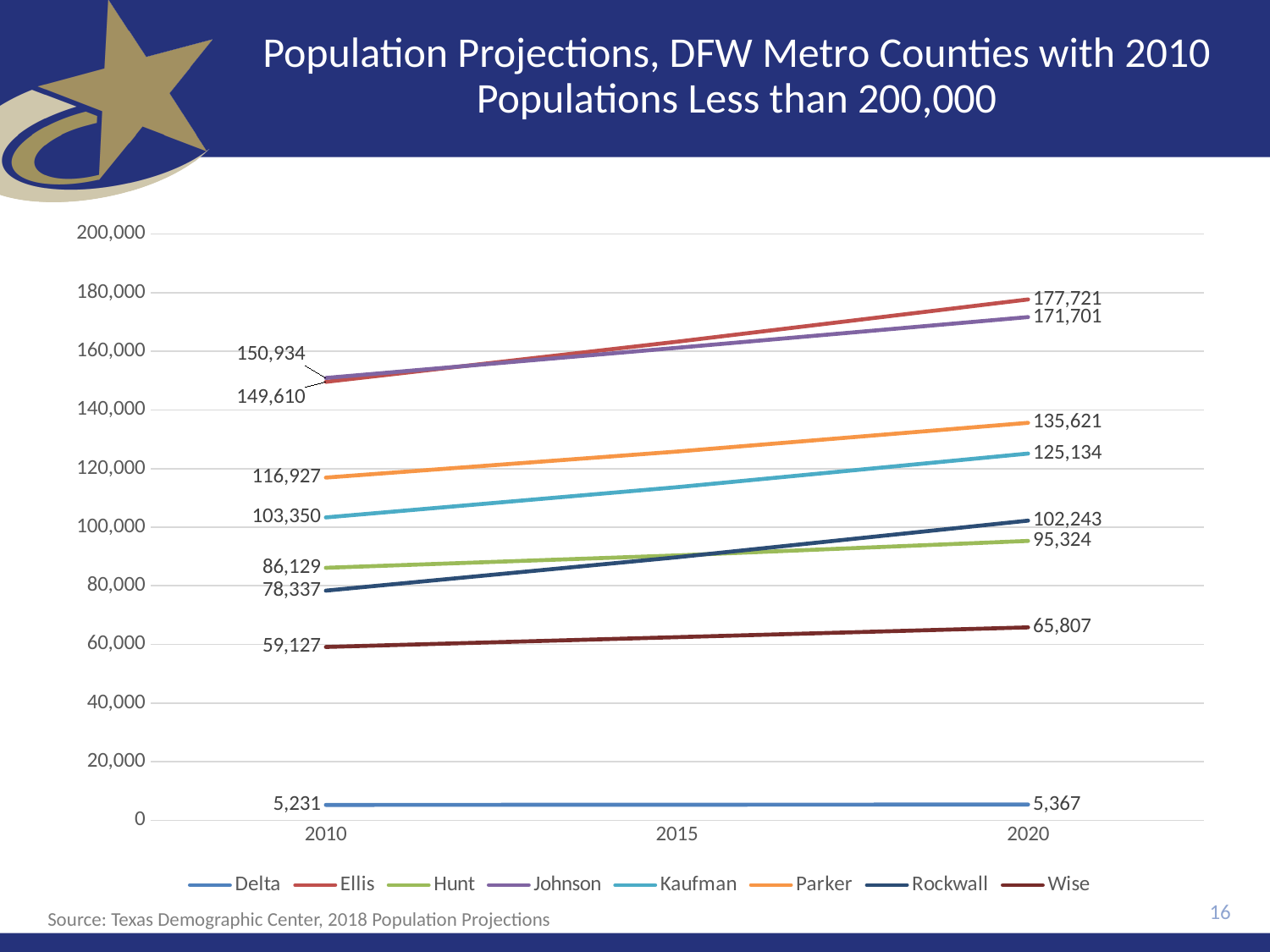
What is the projected population of Ellis County in 2020? 177,721 Which county has the highest projected population in 2020? Ellis Does the population of Johnson County rise or fall from 2010 to 2020? rise What type of chart is shown on the slide? line chart What is the 2010 population of Kaufman County? 103,350 Is the value for Wise County in 2015 greater or less than 80,000? less How many series does the legend list? 8 What is the difference between Parker County's 2020 and 2010 populations? 18,694 Which is larger in 2020, the population of Hunt County or Rockwall County? Rockwall Which county has the lowest population in 2010? Delta How many years are shown on the x axis? 3 What is the projected population of Rockwall County in 2020? 102,243